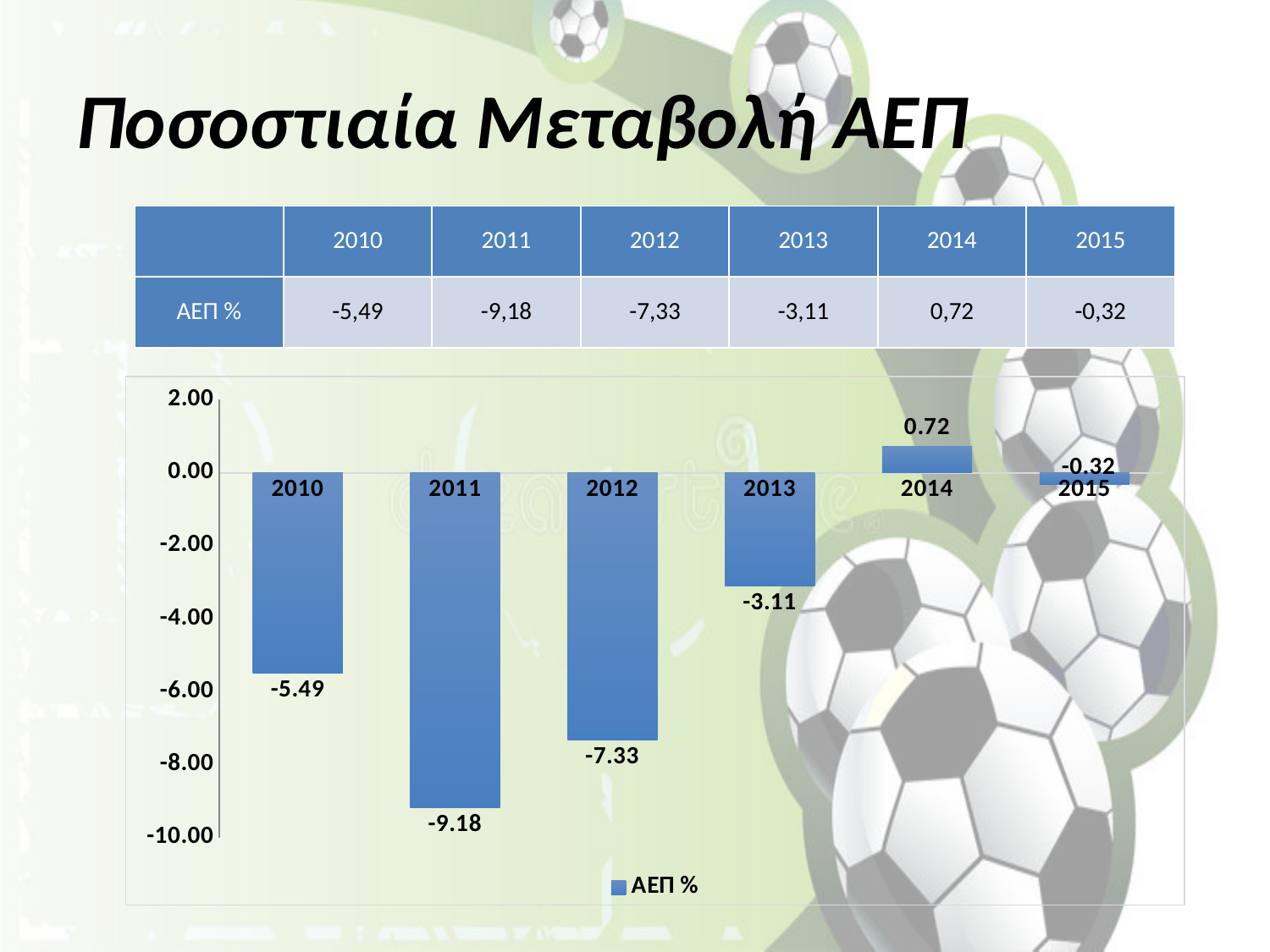
What is the value for 2011 in the chart? -9.18 What is the legend entry of the chart? ΑΕΠ % Which year has the highest value in the chart? 2014 How many years are shown in the chart? 6 What kind of chart is shown on the slide? bar chart Which year has the larger value in the chart, 2012 or 2013? 2013 Is the value for 2012 in the chart greater or less than -6.00? less What is the value for 2014 in the chart? 0.72 Which year has the lowest value in the chart? 2011 What is the difference between the values for 2010 and 2013 in the chart? 2.38 How many series does the chart legend list? 1 What is the value for 2015 in the chart? -0.32